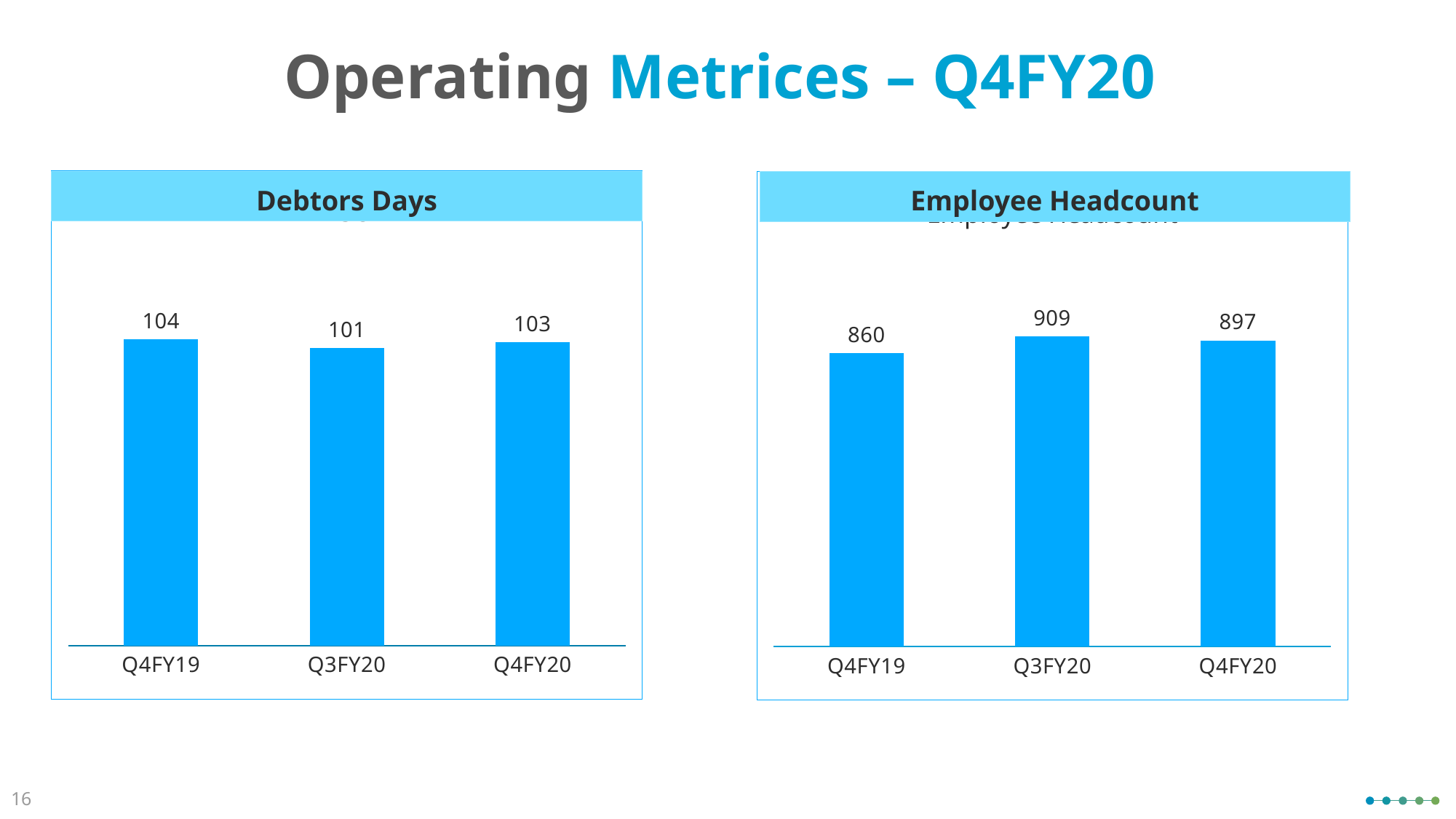
In the Debtors Days chart, which quarter has the highest value? Q4FY19 In the Debtors Days chart, what is the value for Q4FY20? 103 In the Employee Headcount chart, what is the value for Q4FY19? 860 In the Employee Headcount chart, which quarter has the highest value? Q3FY20 In the Employee Headcount chart, what is the value for Q4FY20? 897 In the Debtors Days chart, what is the difference between Q4FY19 and Q3FY20? 3 What type of chart is the Employee Headcount chart? Bar chart In the Employee Headcount chart, what is the difference between Q3FY20 and Q4FY19? 49 In the Debtors Days chart, what is the value for Q3FY20? 101 In the Employee Headcount chart, which quarter has the lowest value? Q4FY19 In the Employee Headcount chart, which is larger, Q3FY20 or Q4FY20? Q3FY20 How many bars are in the Debtors Days chart? 3